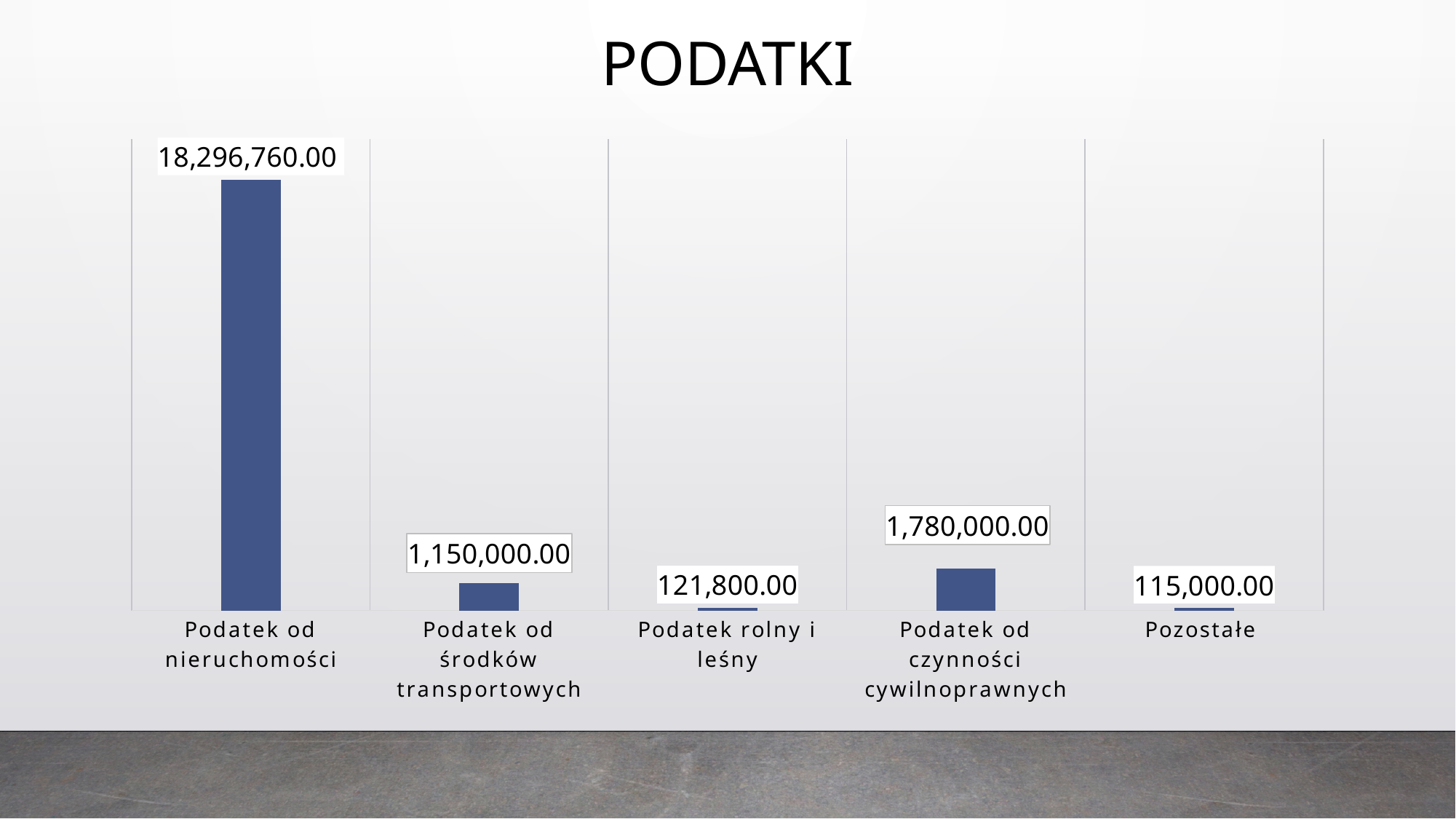
What is the value for Podatek od nieruchomości? 18,296,760.00 Which category has the lowest value? Pozostałe How many categories are shown in the chart? 5 What is the difference between Podatek od czynności cywilnoprawnych and Podatek od środków transportowych? 630,000.00 What is the difference between Podatek rolny i leśny and Pozostałe? 6,800.00 What kind of chart is shown on the slide? Bar chart What is the value for Pozostałe? 115,000.00 What is the value for Podatek od środków transportowych? 1,150,000.00 What is the value for Podatek rolny i leśny? 121,800.00 What is the value for Podatek od czynności cywilnoprawnych? 1,780,000.00 Which category has the highest value? Podatek od nieruchomości Which is larger, Podatek od czynności cywilnoprawnych or Podatek od środków transportowych? Podatek od czynności cywilnoprawnych